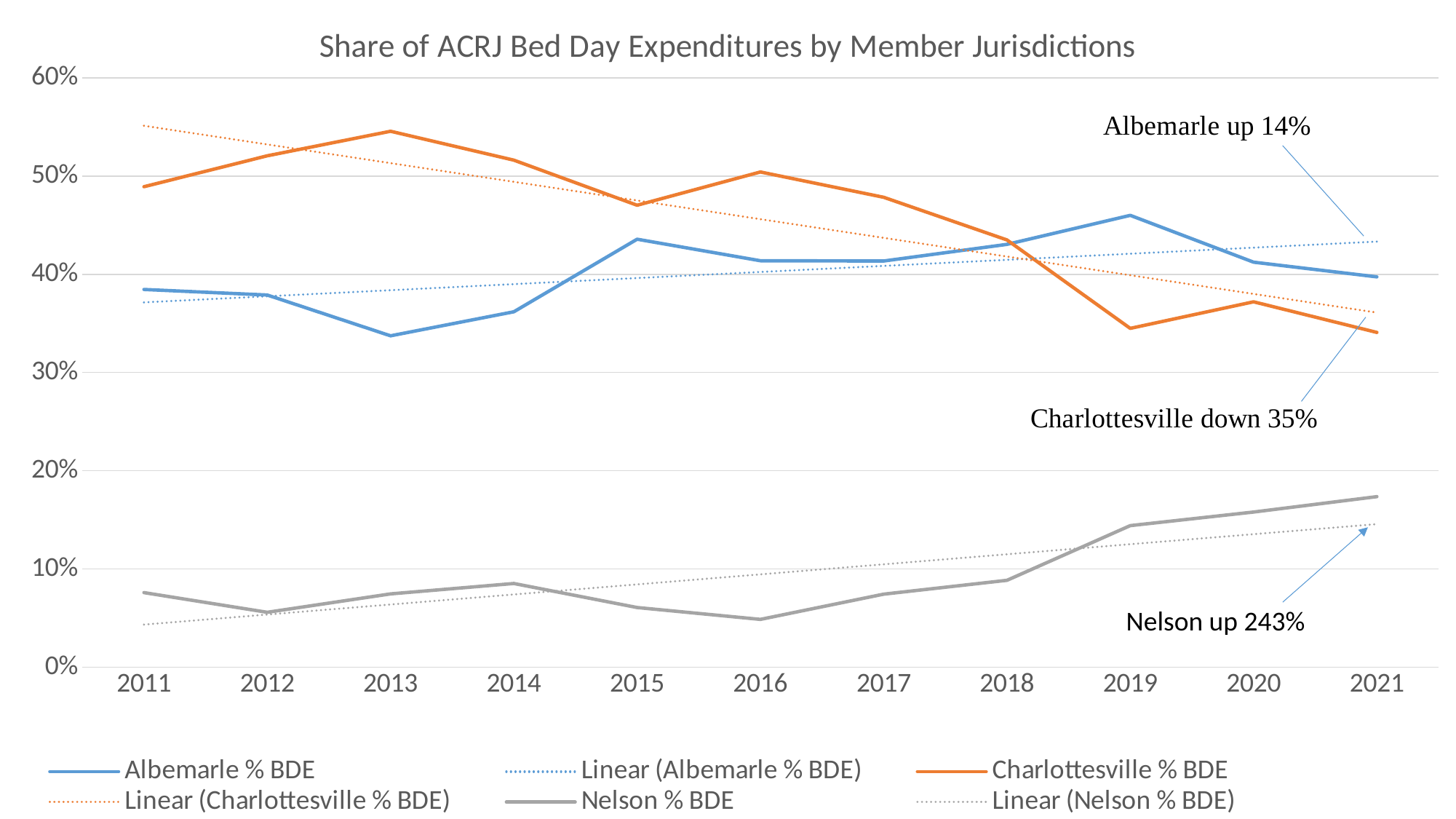
In 2021, which is larger: Albemarle % BDE or Charlottesville % BDE? Albemarle % BDE How many entries does the legend list? 6 In which year does the Nelson % BDE line reach its highest value? 2021 What is the title of the chart? Share of ACRJ Bed Day Expenditures by Member Jurisdictions Is the Charlottesville % BDE value for 2011 greater or less than 40%? greater Does the Nelson % BDE line generally rise or fall from 2011 to 2021? Rise How many years are plotted along the x axis? 11 Is the Nelson % BDE value for 2021 greater or less than 20%? less What kind of chart is shown on the slide? Line chart In which year does the Charlottesville % BDE line reach its highest value? 2013 According to the annotation on the chart, by what percentage is Nelson up? 243% In which year does the Albemarle % BDE line reach its lowest value? 2013